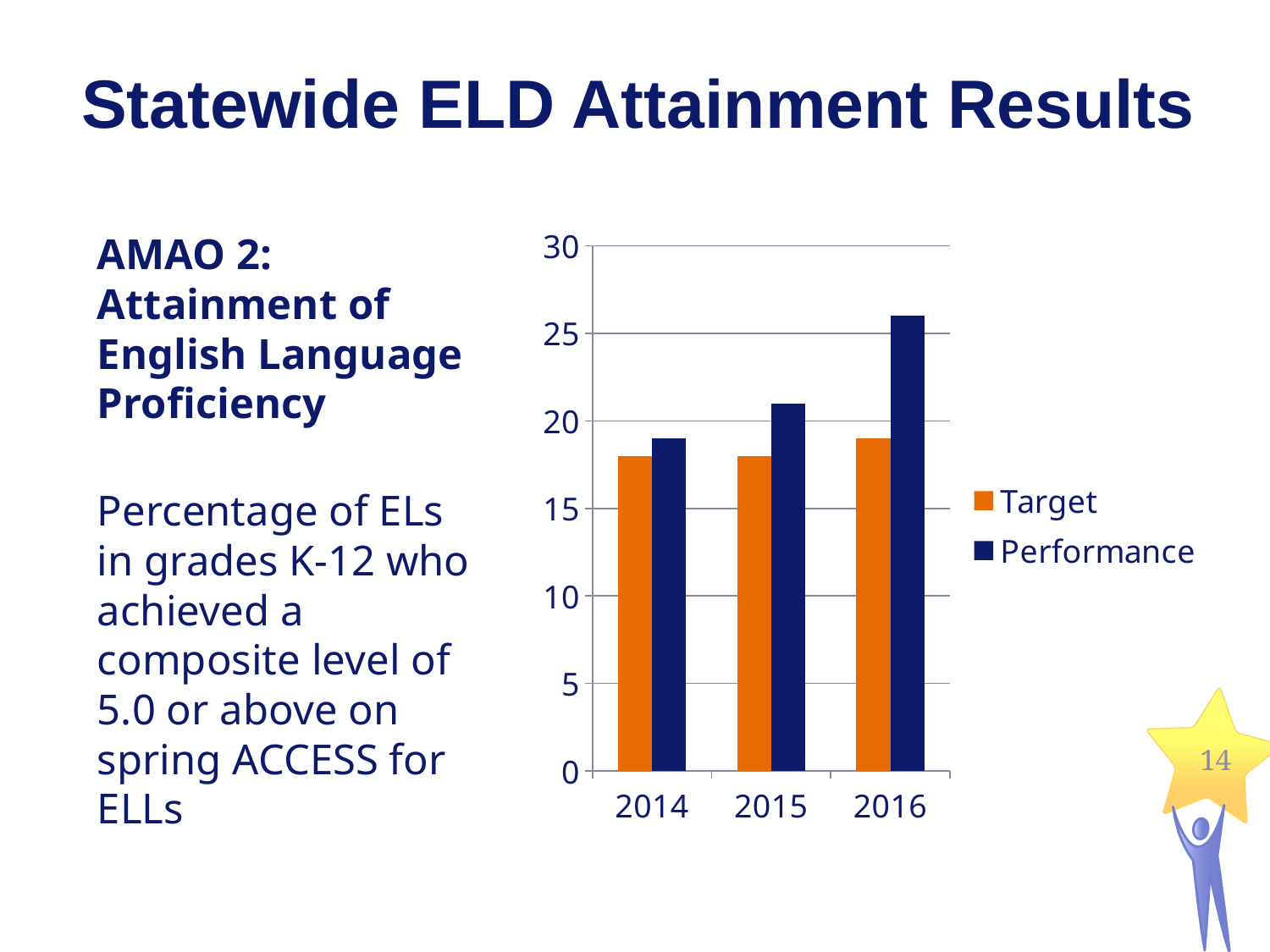
Is the Performance value for 2016 greater or less than 25? greater Which year has the lowest Performance value? 2014 Is the Performance value for 2014 greater or less than 20? less Is the Target value for 2014 greater or less than 20? less Which colour represents the Target series in the chart? orange How many years are shown on the x axis of the chart? 3 In 2016, which is larger, Target or Performance? Performance How many series does the chart's legend list? 2 What kind of chart is shown on the slide? bar chart Which year has the highest Performance value? 2016 Does the Performance value rise or fall from 2014 to 2016? rise